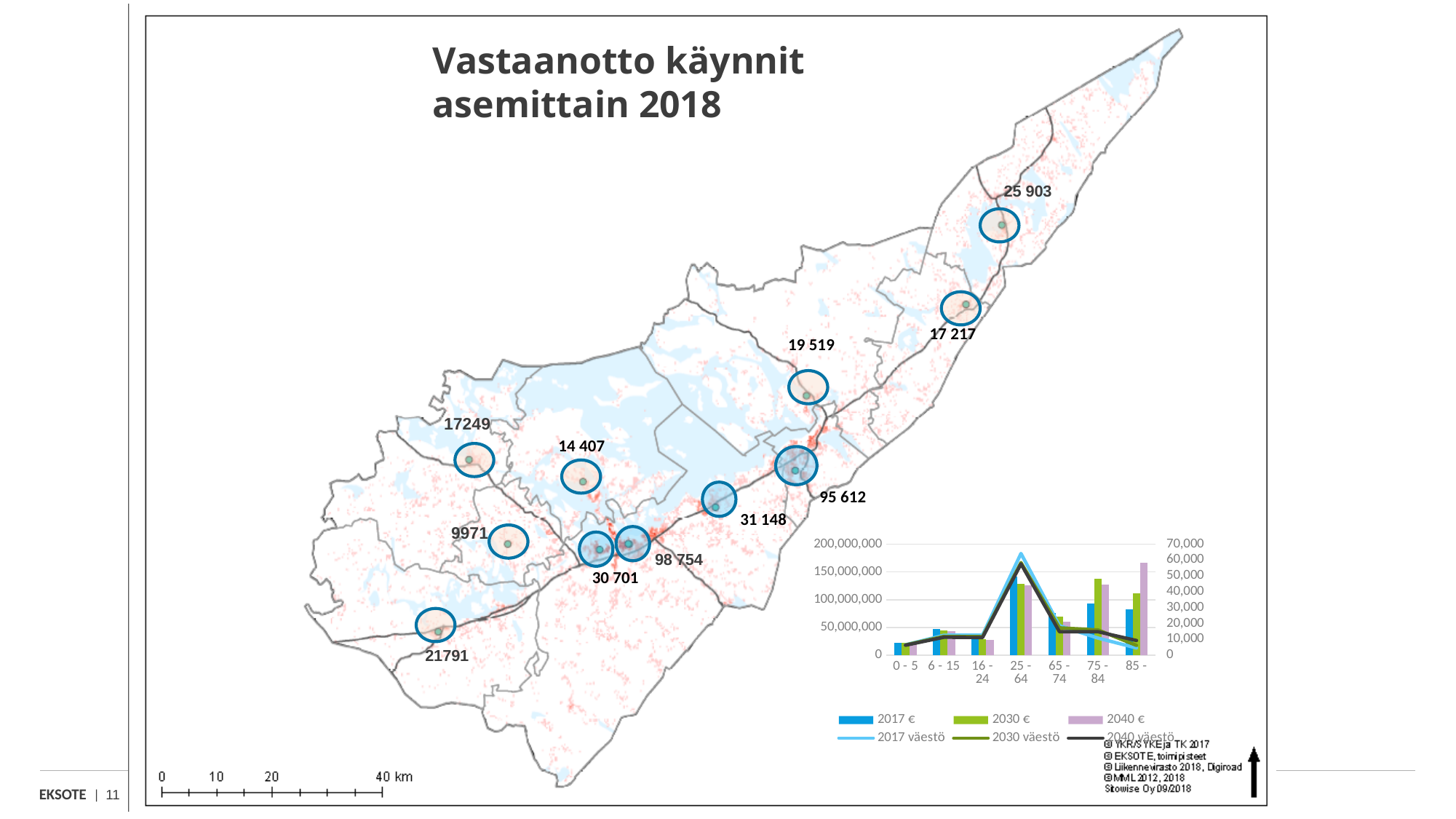
In the bottom-right chart, is the 2017 € value for the 25 - 64 age group greater or less than 100,000,000? greater How many age-group categories are shown on the x axis of the bottom-right chart? 7 In the bottom-right chart, do the 2040 € bars rise or fall from the 65 - 74 group to the 85 - group? rise In the bottom-right chart, which is larger for the 85 - age group: the 2017 € bar or the 2040 € bar? 2040 € In the bottom-right chart, which is larger for the 75 - 84 age group: the 2017 € bar or the 2030 € bar? 2030 € In the bottom-right chart, what is the maximum value shown on the left vertical axis? 200,000,000 How many series does the legend of the bottom-right chart list? 6 In the bottom-right chart, what is the maximum value shown on the right vertical axis? 70,000 In the bottom-right chart, which age group has the highest 2017 € bar? 25 - 64 In the bottom-right chart, is the 2017 € value for the 0 - 5 age group greater or less than 50,000,000? less What kind of chart is shown in the bottom-right corner of the slide? A combined bar and line chart In the bottom-right chart, is the 2040 € value for the 85 - age group greater or less than 150,000,000? greater